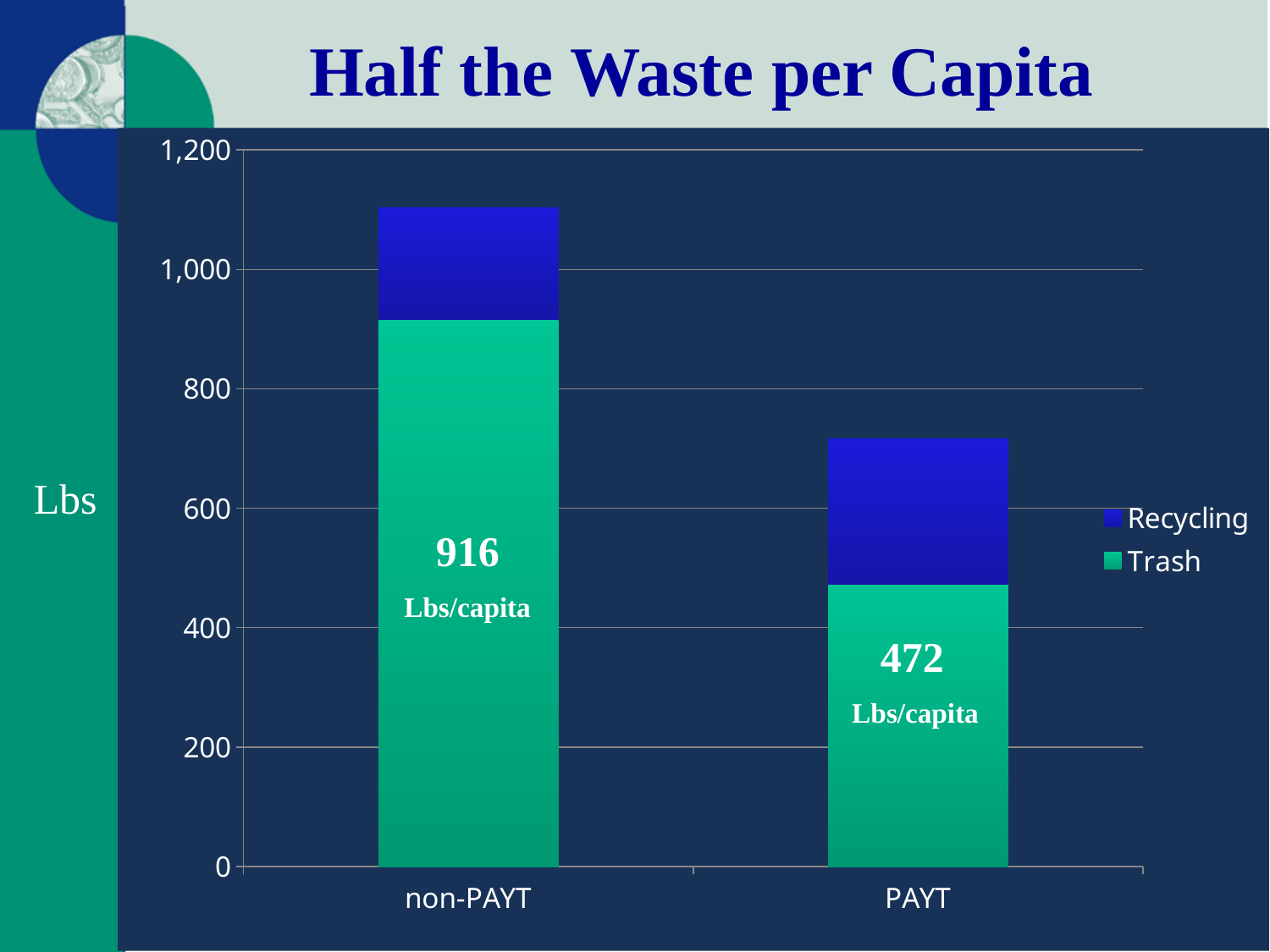
Is the total stacked bar for PAYT greater or less than 800? less Which category has the lowest total bar height? PAYT What kind of chart is shown on the slide? Stacked bar chart What is the title of the slide? Half the Waste per Capita What is the Trash value for non-PAYT? 916 Lbs/capita How many series does the legend list? 2 What are the two series listed in the legend? Recycling and Trash How many categories are shown on the x axis? 2 Is the total stacked bar for non-PAYT greater or less than 1,000? greater What is the Trash value for PAYT? 472 Lbs/capita Which category has the higher Trash value, non-PAYT or PAYT? non-PAYT What is the difference between the Trash values for non-PAYT and PAYT? 444 Lbs/capita